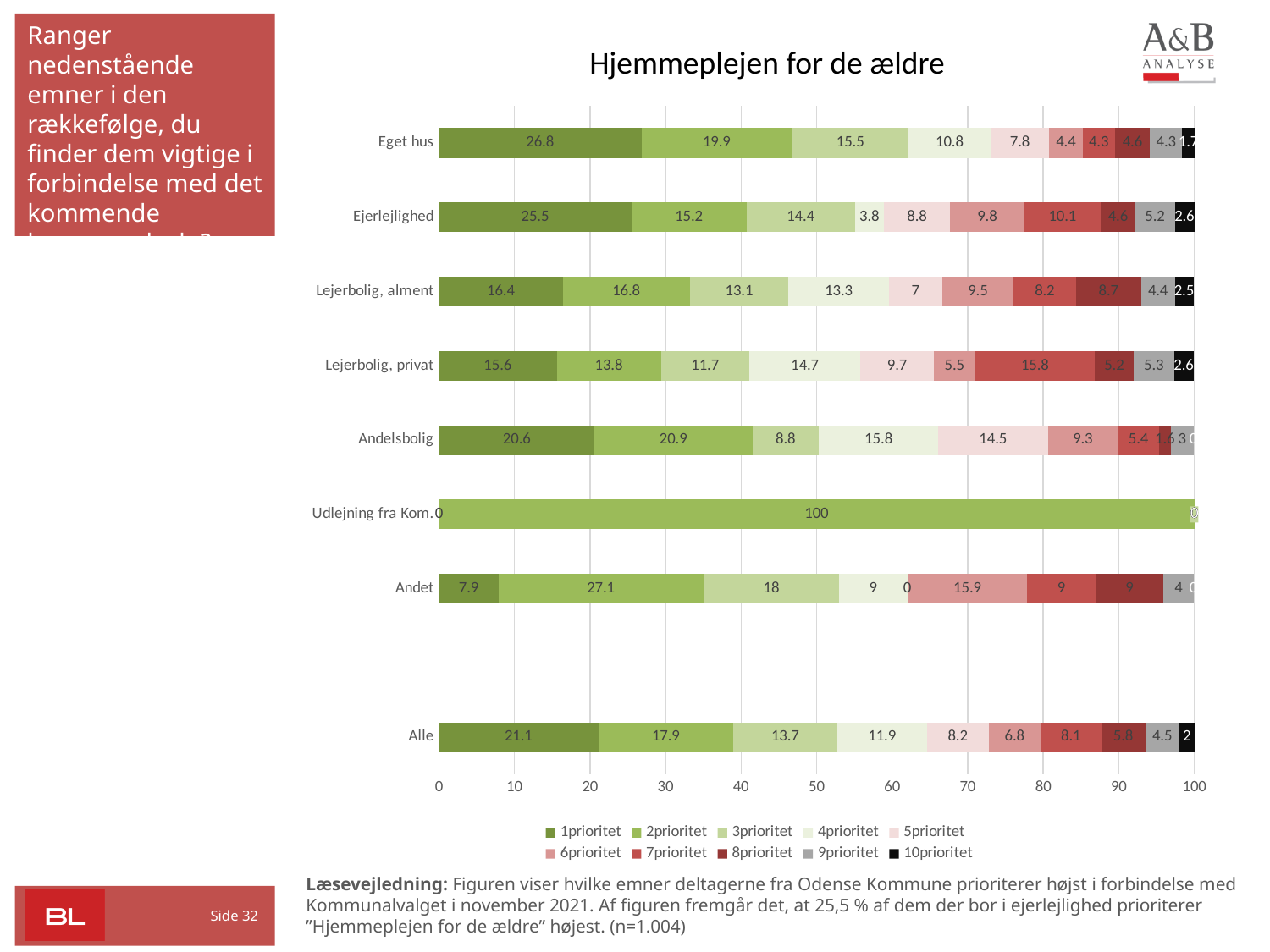
What kind of chart is shown on the slide? Stacked bar chart How many categories are shown on the vertical axis of the chart? 8 What is the 7prioritet value for Lejerbolig, privat? 15.8 Which category has the highest 1prioritet value? Eget hus What is the 2prioritet value for Udlejning fra Kom.? 100 What is the 10prioritet value for Alle? 2 What is the difference between the 1prioritet value for Eget hus and the 1prioritet value for Alle? 5.7 How many series does the legend list? 10 What is the 1prioritet value for Ejerlejlighed? 25.5 What is the title of the chart? Hjemmeplejen for de ældre Which has the larger 2prioritet value, Ejerlejlighed or Lejerbolig, alment? Lejerbolig, alment What is the 2prioritet value for Andet? 27.1